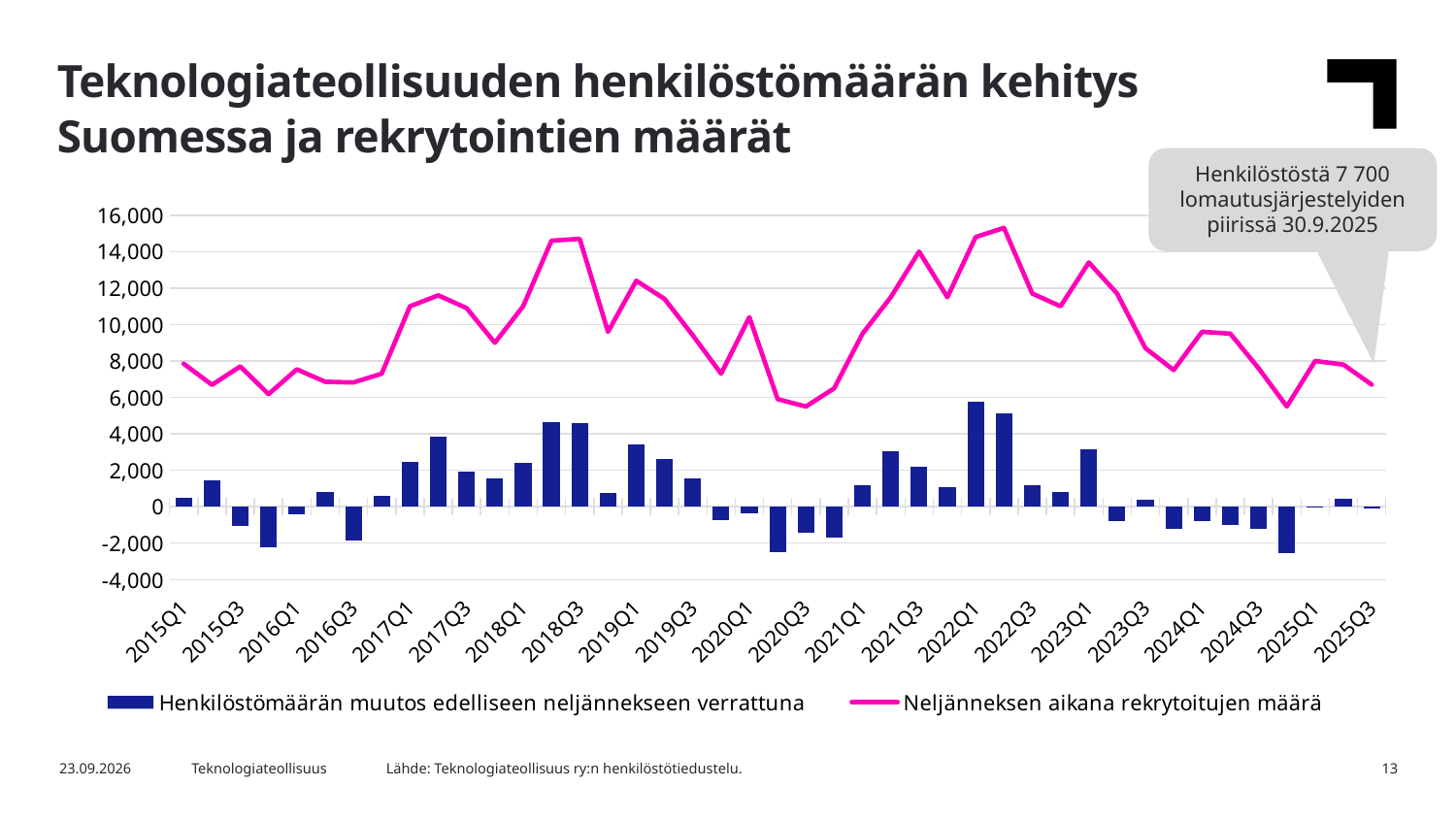
Is the value of the 'Neljänneksen aikana rekrytoitujen määrä' line at 2025Q3 greater or less than 8,000? less Is the bar for 'Henkilöstömäärän muutos edelliseen neljännekseen verrattuna' at 2022Q1 greater or less than 4,000? greater Is the highest point of the 'Neljänneksen aikana rekrytoitujen määrä' line greater or less than 14,000? greater Which quarter has the tallest bar for 'Henkilöstömäärän muutos edelliseen neljännekseen verrattuna'? 2022Q1 How many series does the legend list? 2 Which is larger for the 'Neljänneksen aikana rekrytoitujen määrä' line: the value at 2022Q1 or the value at 2015Q1? 2022Q1 Does the 'Neljänneksen aikana rekrytoitujen määrä' line generally rise or fall from 2022Q1 to 2025Q3? fall What kind of chart is shown on the slide? A combined bar and line chart Which series is drawn as a line: 'Henkilöstömäärän muutos edelliseen neljännekseen verrattuna' or 'Neljänneksen aikana rekrytoitujen määrä'? Neljänneksen aikana rekrytoitujen määrä What is the title of the chart on the slide? Teknologiateollisuuden henkilöstömäärän kehitys Suomessa ja rekrytointien määrät